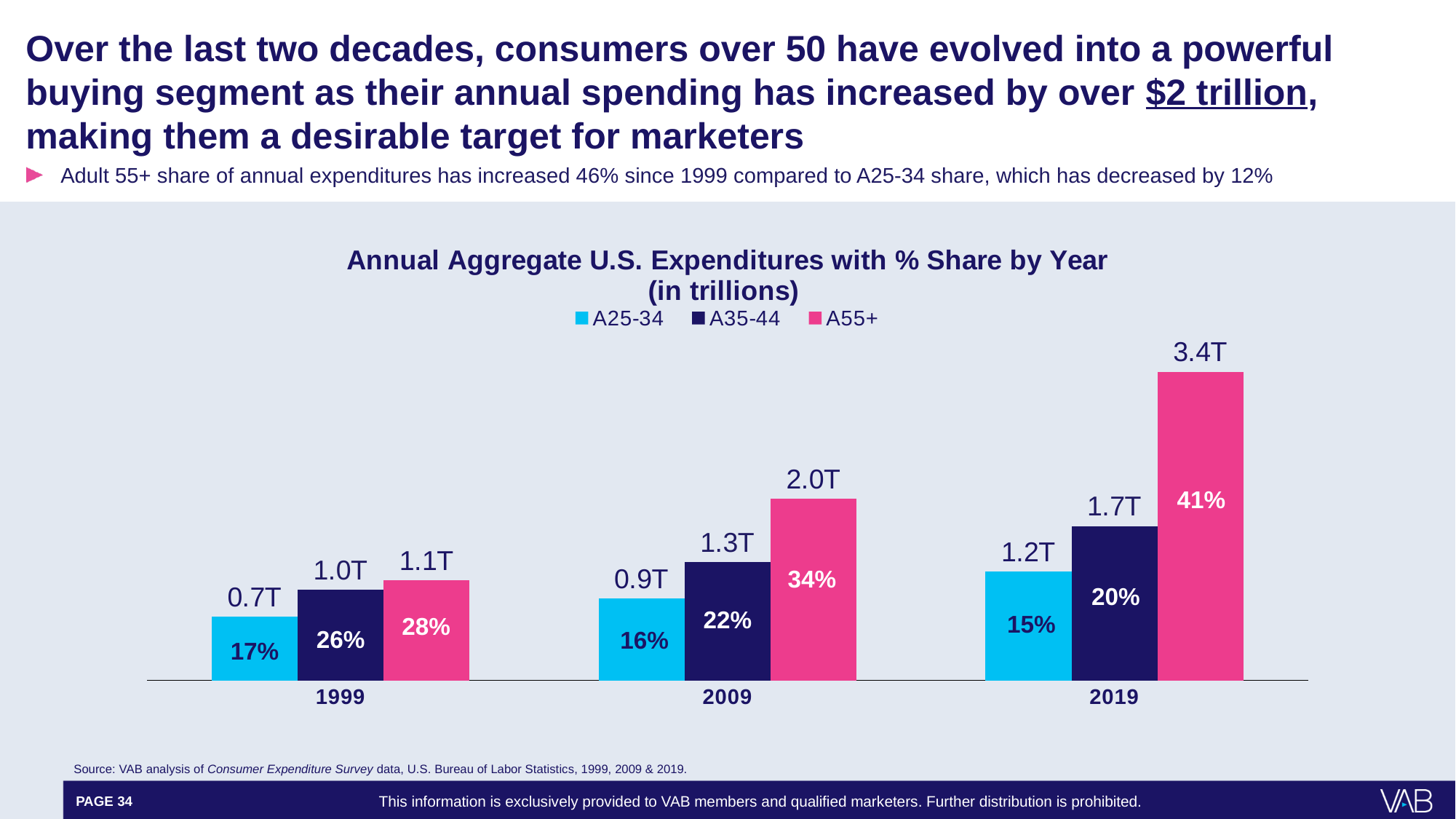
Which series has the lowest value in 1999? A25-34 Which is larger, the A35-44 value in 2009 or the A25-34 value in 2019? A35-44 in 2009 How many years are shown on the x axis? 3 How many series does the legend list? 3 What is the value for A55+ in 2019? 3.4T What kind of chart is shown? Bar chart What is the title of the chart? Annual Aggregate U.S. Expenditures with % Share by Year (in trillions) Does the A55+ value rise or fall from 1999 to 2019? Rise Which series has the highest value in 2019? A55+ What is the difference between the A55+ value and the A25-34 value in 2019? 2.2T What is the value for A25-34 in 1999? 0.7T What percentage share is shown for A35-44 in 2009? 22%